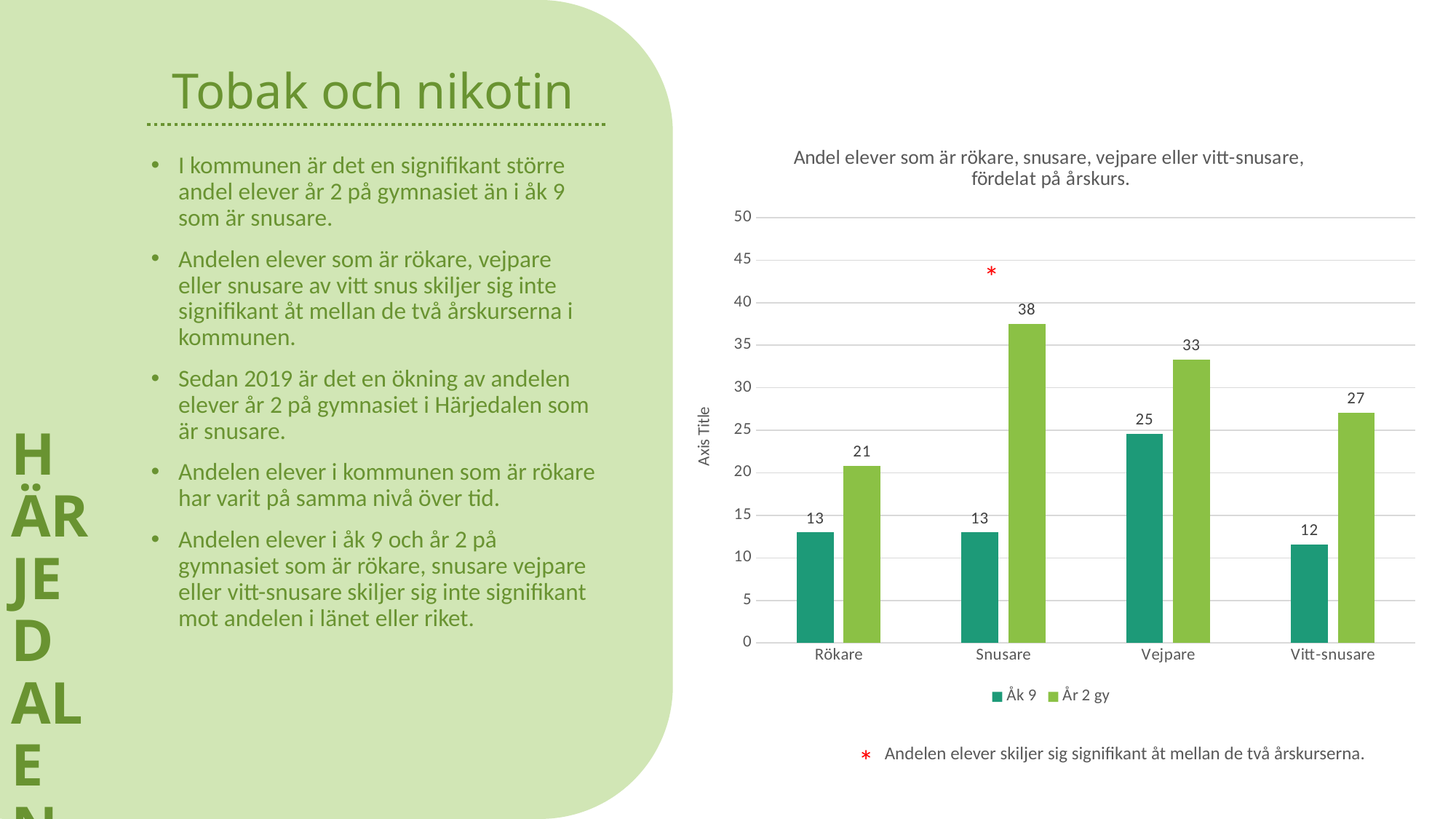
Which category is marked with a red asterisk above its bars? Snusare Which category has the highest value for År 2 gy? Snusare Which is larger: the Åk 9 value for Vejpare or the Åk 9 value for Rökare? Vejpare How many series does the legend list? 2 What is the value for År 2 gy in the Vitt-snusare category? 27 Which category has the lowest value for Åk 9? Vitt-snusare How many categories are shown on the x axis? 4 What kind of chart is shown on the slide? bar chart What is the value for År 2 gy in the Vejpare category? 33 What is the value for Åk 9 in the Snusare category? 13 What is the difference between the År 2 gy and Åk 9 values for Snusare? 25 Is the value for År 2 gy in the Rökare category greater or less than 25? less